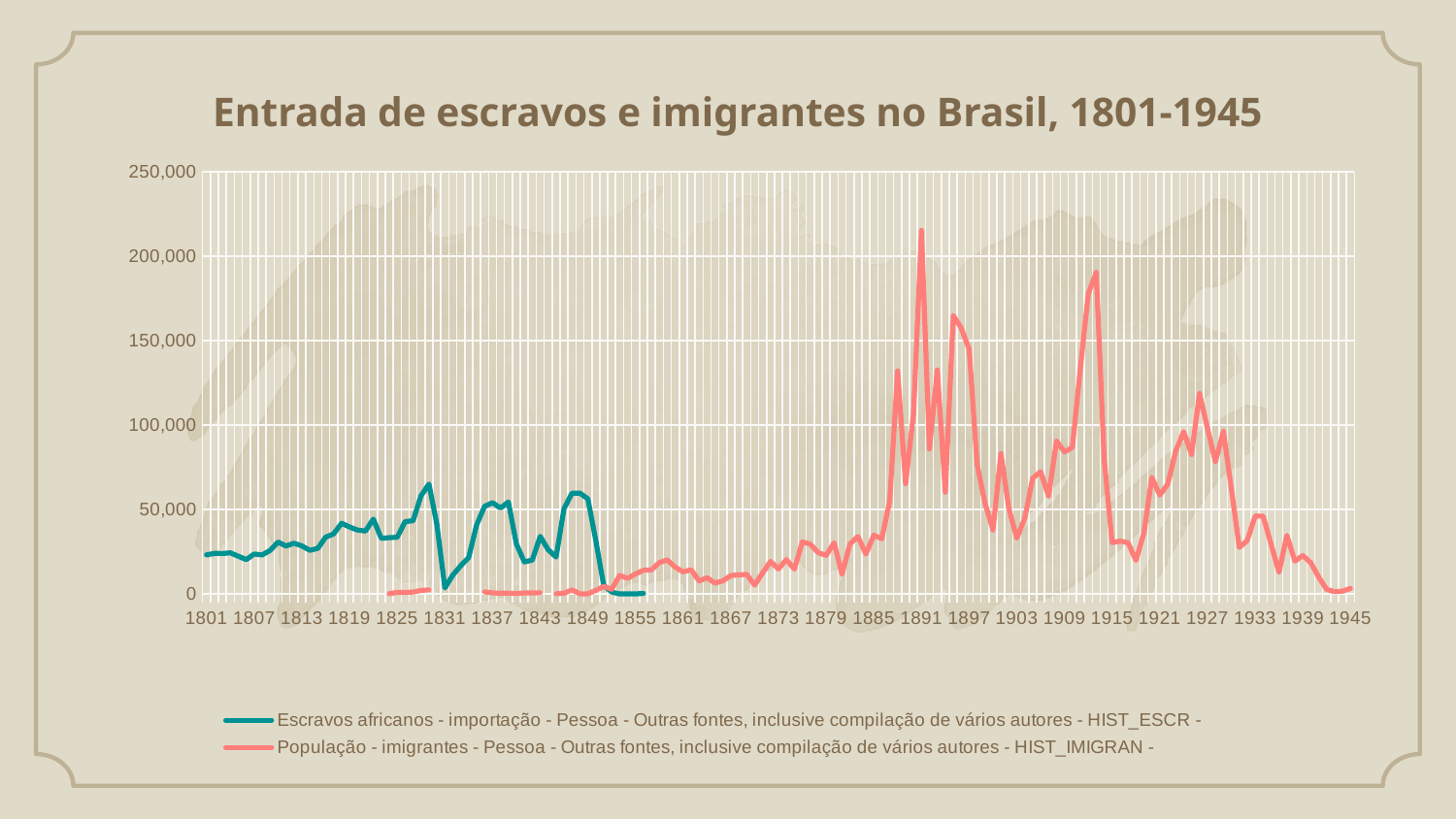
What is the highest value shown on the y axis? 250,000 Is the highest value of the 'Escravos africanos - importação' series greater or less than 50,000? greater Does the 'População - imigrantes' series rise or fall between 1927 and 1945? Fall Is the value of the 'Escravos africanos - importação' series in 1801 greater or less than 50,000? less Is the peak value of the 'População - imigrantes' series around 1891 greater or less than 200,000? greater What is the title of the chart? Entrada de escravos e imigrantes no Brasil, 1801-1945 How many year labels are shown on the x axis? 25 How many series does the legend list? 2 Which colour is used for the 'Escravos africanos - importação' series? Teal (green) Which series reaches a higher maximum value, 'Escravos africanos - importação' or 'População - imigrantes'? População - imigrantes What kind of chart is shown on the slide? Line chart